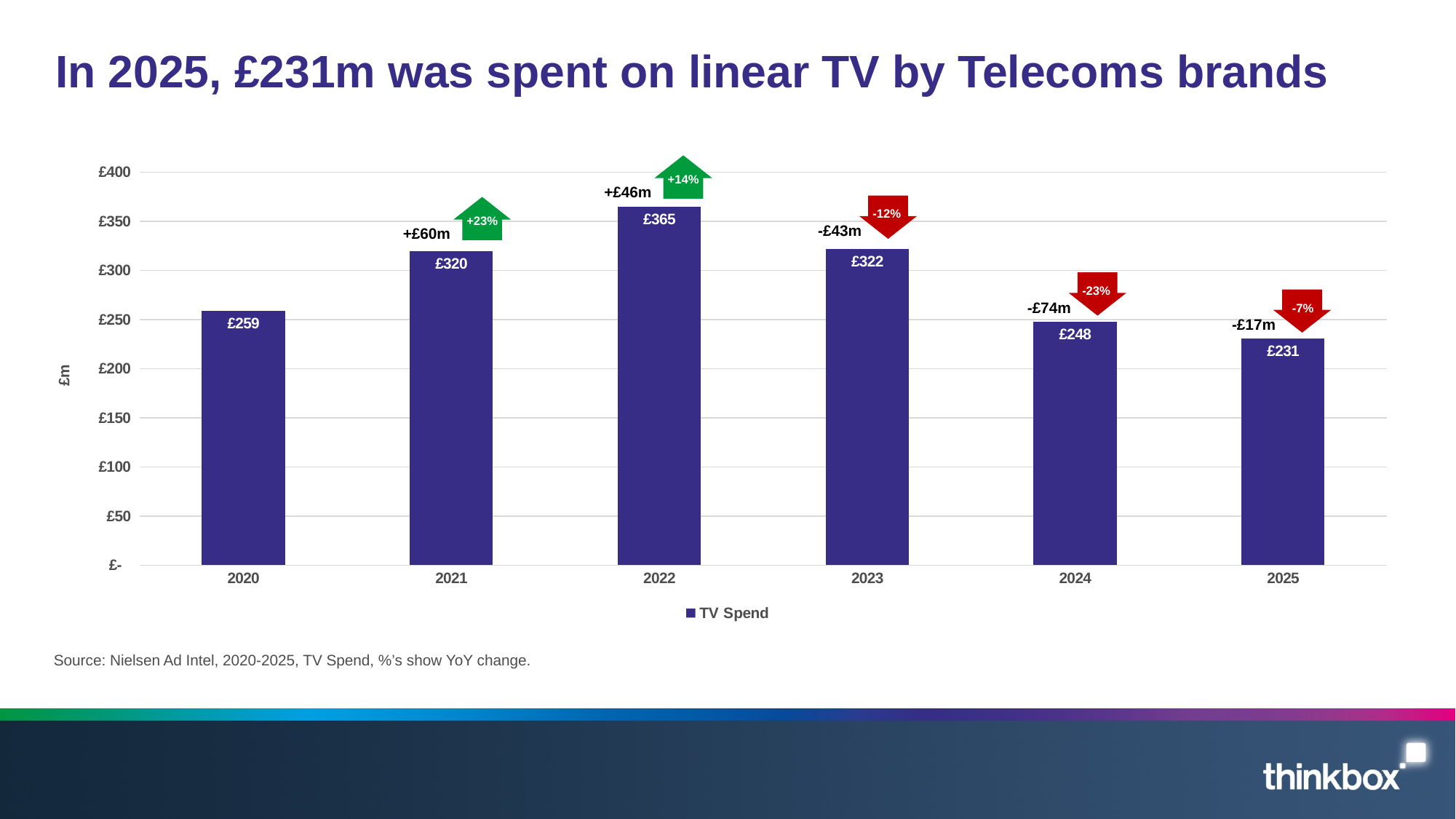
Which year had the lowest TV Spend? 2025 What year-on-year percentage change is shown for 2024? -23% What is the difference between the TV Spend in 2022 and 2023? £43 How many series does the legend list? 1 What kind of chart is shown on the slide? bar chart Is the value for 2024 greater or less than £250? less Which year had the highest TV Spend? 2022 Did TV Spend rise or fall from 2022 to 2025? fall What was the TV Spend in 2022? £365 What was the TV Spend in 2020? £259 Which year had a larger TV Spend, 2021 or 2024? 2021 How many years are shown on the x axis? 6